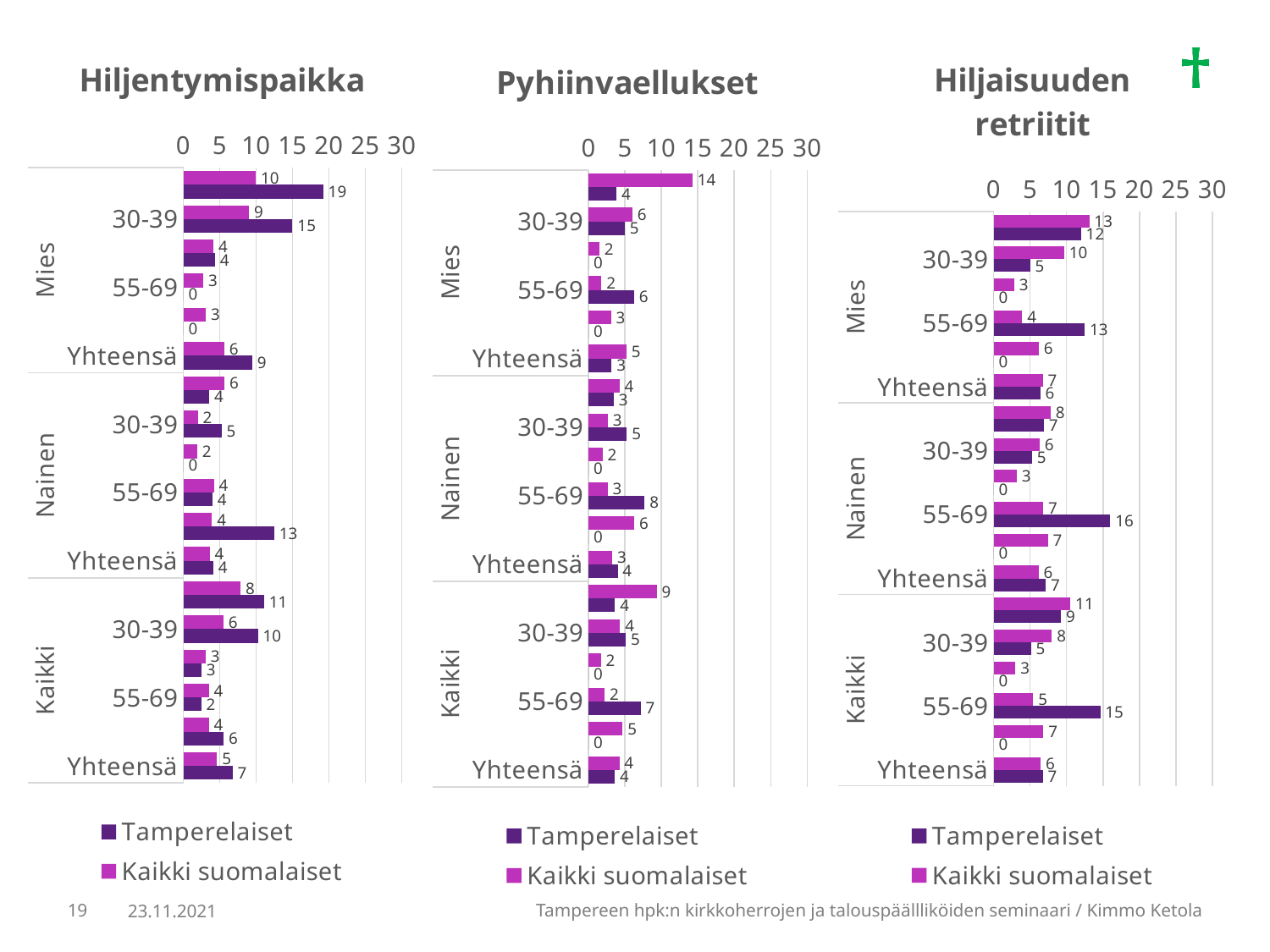
Which series is shown in dark purple in the Hiljaisuuden retriitit chart? Tamperelaiset In the Hiljentymispaikka chart, what is the Kaikki suomalaiset value for Kaikki Yhteensä? 5 In the Pyhiinvaellukset chart, what is the Tamperelaiset value for Nainen 55-69? 8 In the Hiljaisuuden retriitit chart, what is the difference between the Tamperelaiset and Kaikki suomalaiset values for Kaikki 55-69? 10 In the Pyhiinvaellukset chart, which is larger for Mies 55-69: Tamperelaiset or Kaikki suomalaiset? Tamperelaiset In the Hiljaisuuden retriitit chart, what is the Tamperelaiset value for Nainen 55-69? 16 How many series does the legend of the Pyhiinvaellukset chart list? 2 What kind of chart is the Hiljentymispaikka chart? Bar chart In the Hiljentymispaikka chart, what is the Tamperelaiset value for Mies 30-39? 15 In the Hiljentymispaikka chart, what is the difference between the Tamperelaiset and Kaikki suomalaiset values for Kaikki 30-39? 4 In the Hiljaisuuden retriitit chart, which is larger for Mies 30-39: Tamperelaiset or Kaikki suomalaiset? Kaikki suomalaiset In the Pyhiinvaellukset chart, what is the Kaikki suomalaiset value for Mies Yhteensä? 5